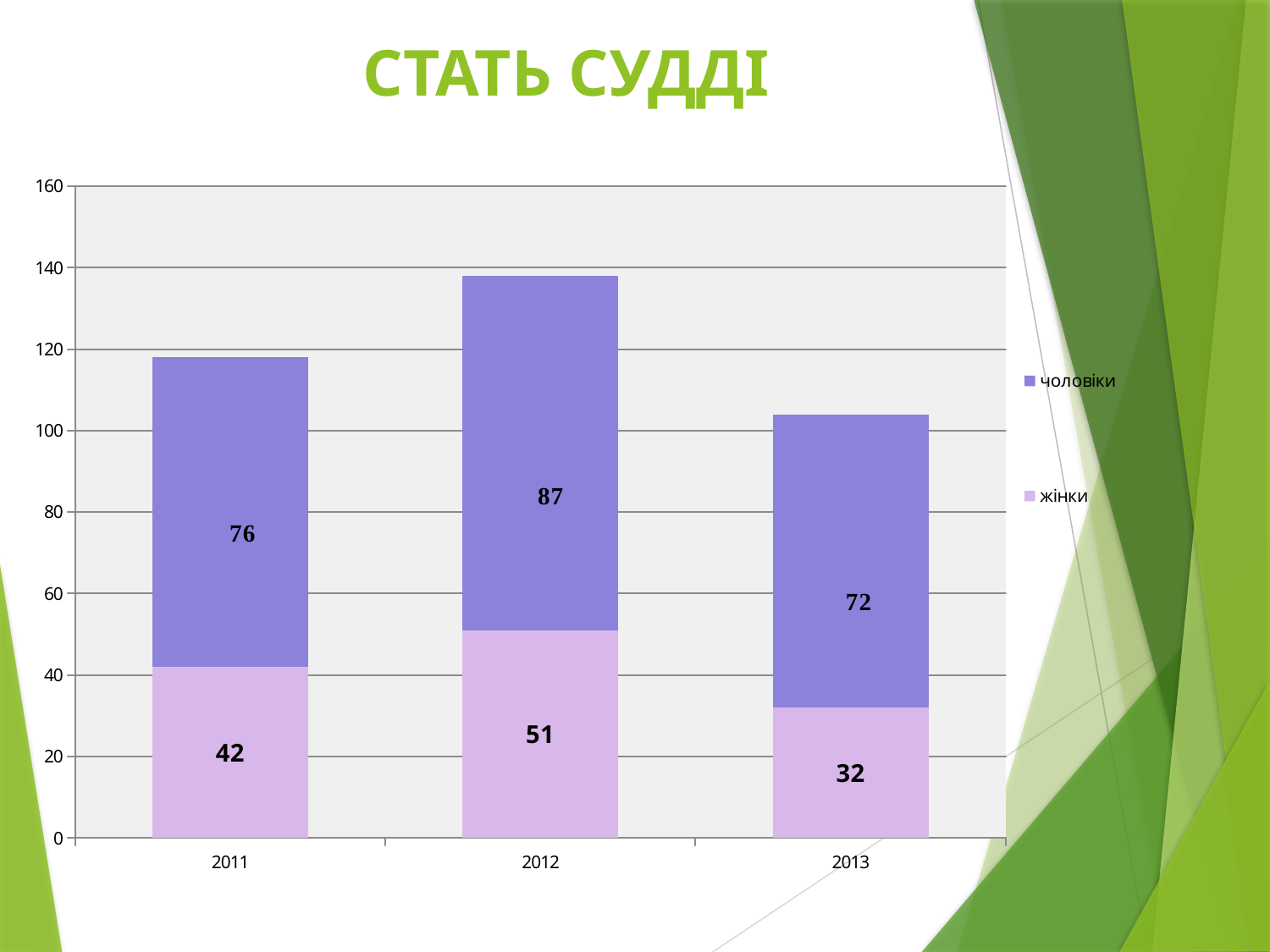
What is the difference between чоловіки and жінки in 2011? 34 What is the value for жінки in 2013? 32 What kind of chart is shown on the slide? Stacked bar chart Which year has the lowest value for жінки? 2013 What is the value for жінки in 2011? 42 What is the total of the stacked bar for 2012? 138 How many years are shown on the x axis? 3 Which year has the highest value for чоловіки? 2012 What is the total of the stacked bar for 2013? 104 What is the value for чоловіки in 2012? 87 How many series does the legend list? 2 Which is larger: жінки in 2012 or жінки in 2013? жінки in 2012